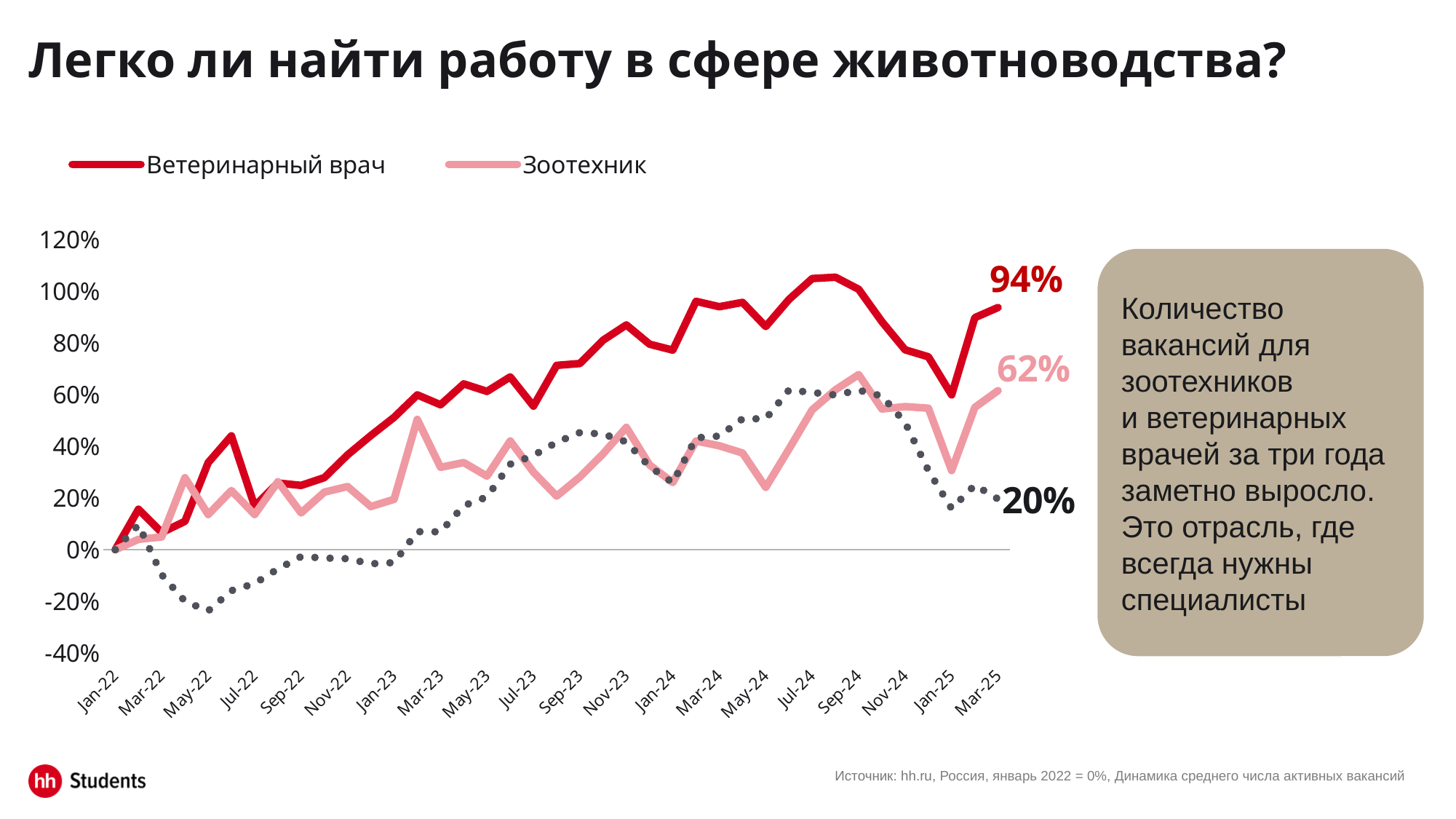
What value does the dotted grey line end at? 20% Which colour represents Зоотехник in the legend? Light pink How many series does the legend list? 2 What is the final value shown for Ветеринарный врач at the end of the line? 94% What kind of chart is shown on the slide? Line chart Is the value for Ветеринарный врач at Jul-24 greater or less than 100%? greater Does the Ветеринарный врач line overall rise or fall from Jan-22 to Mar-25? Rise What is the final value shown for Зоотехник at the end of the line? 62% Is the value for Зоотехник at Jan-25 greater or less than 40%? less Is the value of the dotted grey line at Jul-22 greater or less than 0%? less Which series ends higher, Ветеринарный врач or Зоотехник? Ветеринарный врач What is the difference between the final values of Ветеринарный врач (94%) and Зоотехник (62%)? 32 percentage points